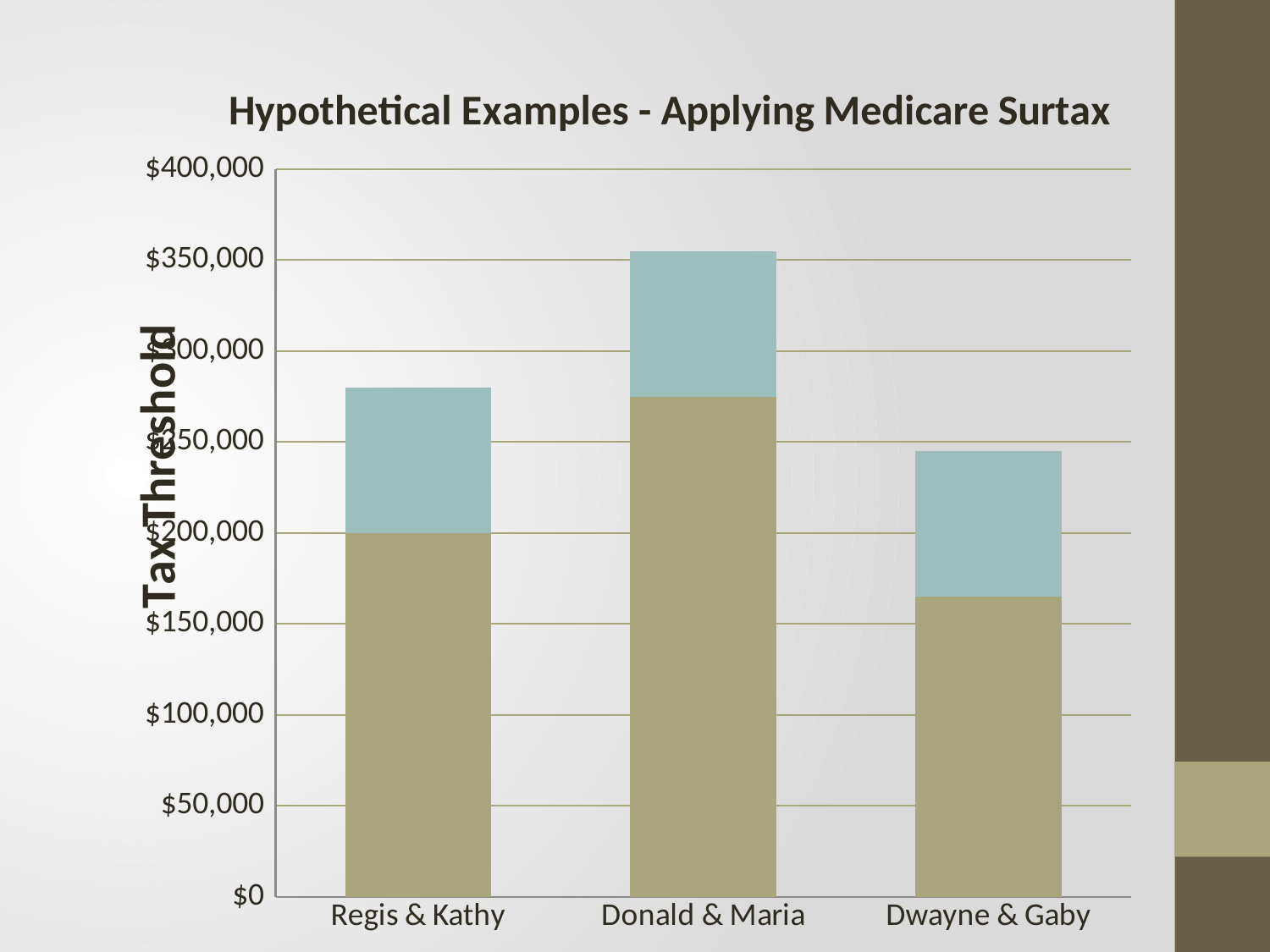
Is the total height of the bar for Regis & Kathy greater or less than $250,000? greater Which couple has the tallest stacked bar overall? Donald & Maria What kind of chart is shown on the slide? bar chart At what value does the lower (tan) segment of the bar for Regis & Kathy end? $200,000 What is the title of the chart? Hypothetical Examples - Applying Medicare Surtax Is the lower (tan) segment of the bar for Dwayne & Gaby greater or less than $150,000? greater Is the total height of the bar for Dwayne & Gaby greater or less than $200,000? greater What is the label on the vertical axis? Tax Threshold Which couple has the shortest stacked bar overall? Dwayne & Gaby How many couples (categories) are shown on the x axis? 3 Which stacked bar is taller overall: Regis & Kathy or Dwayne & Gaby? Regis & Kathy